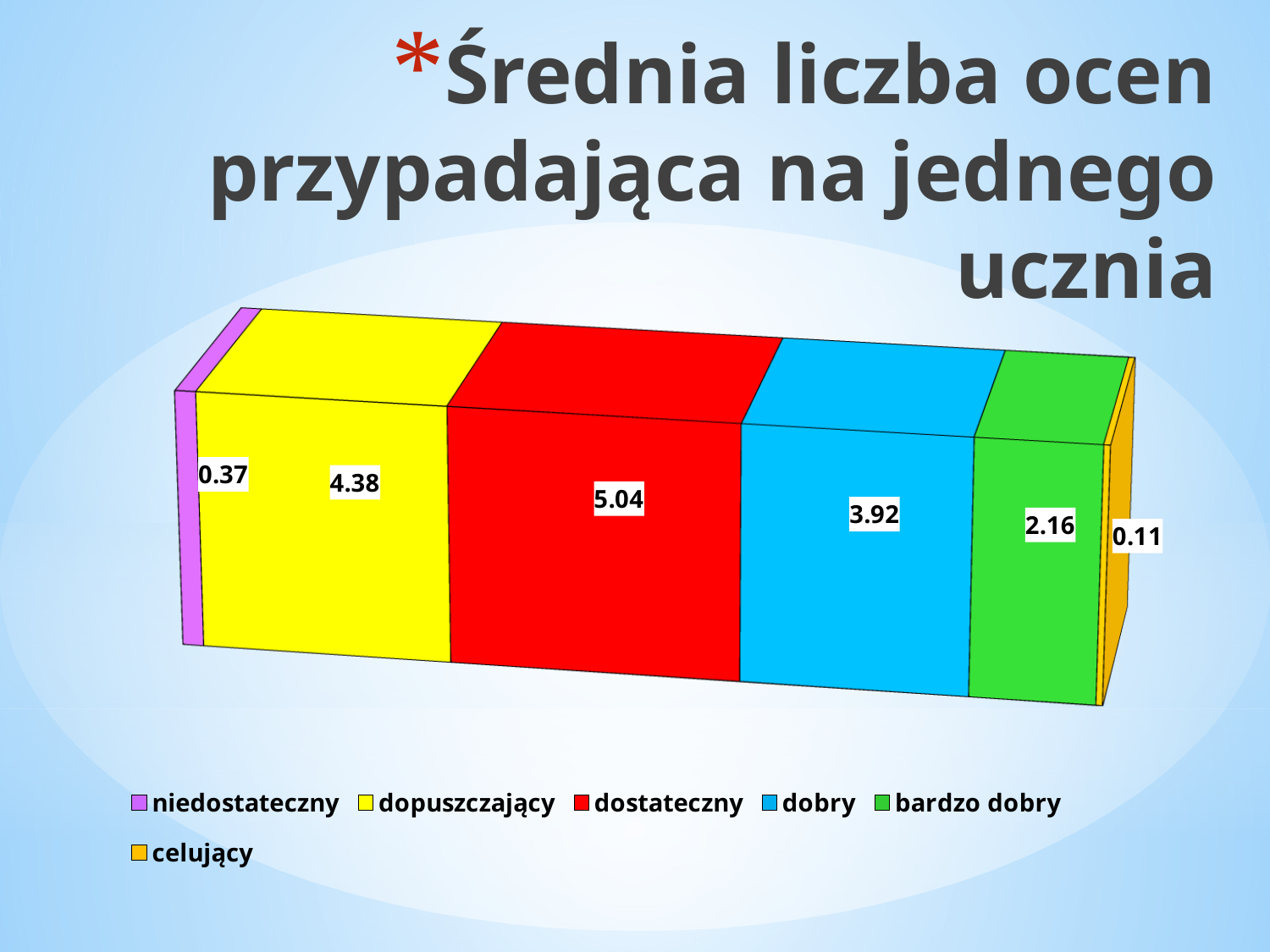
What is the total of the stacked bar? 15.98 What is the difference between the values for dostateczny and dopuszczający? 0.66 What is the difference between the values for dobry and bardzo dobry? 1.76 Which grade category has the highest value? dostateczny What is the value for dostateczny? 5.04 Which is larger, the value for dopuszczający or the value for dobry? dopuszczający How many series does the legend list? 6 What is the value for niedostateczny? 0.37 What is the value for dobry? 3.92 What kind of chart is shown on the slide? stacked bar chart Which grade category has the lowest value? celujący What is the value for celujący? 0.11